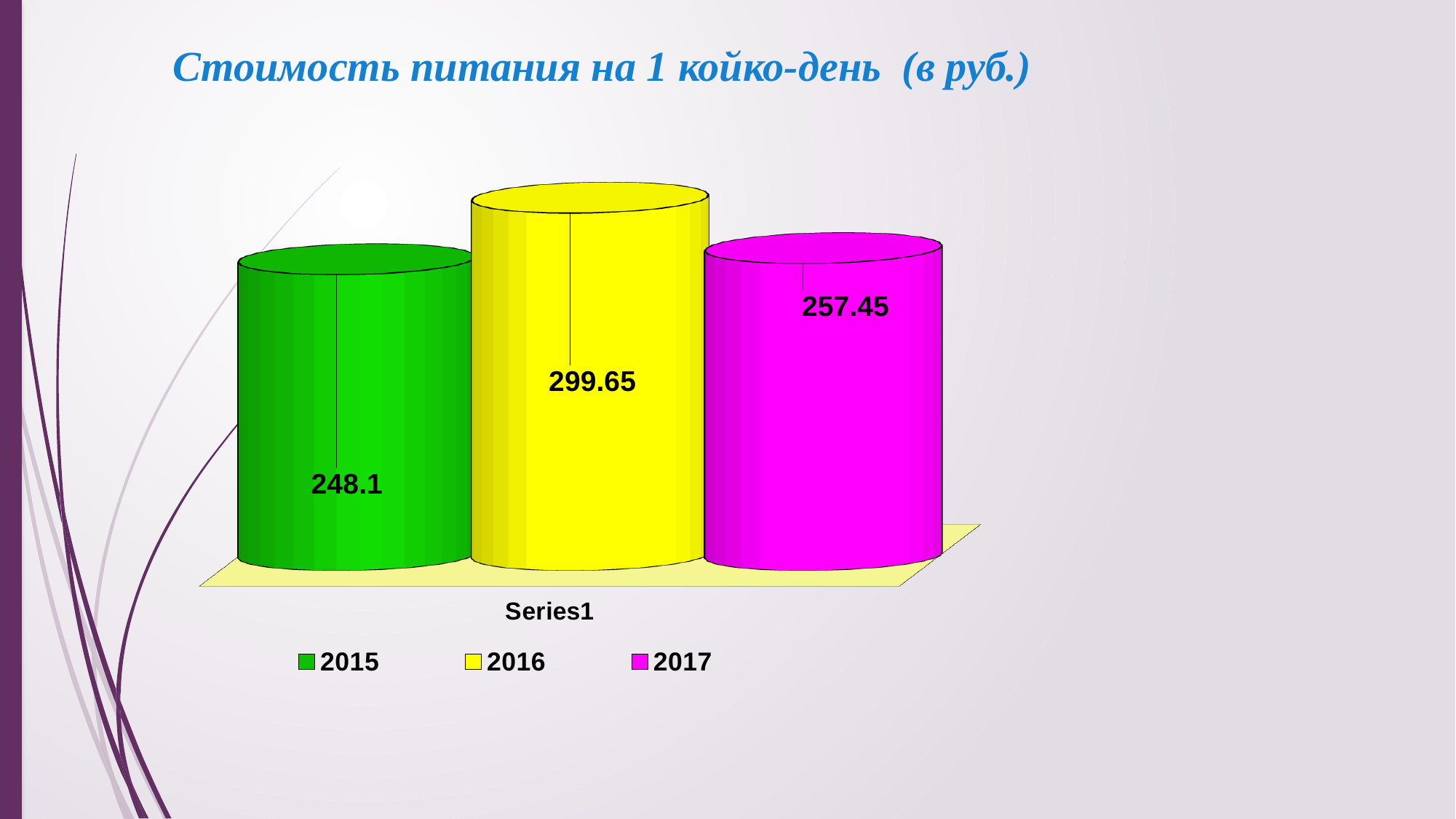
How many series does the legend list? 3 Which year has the lowest value? 2015 What is the difference between the values for 2017 and 2015? 9.35 What is the difference between the values for 2016 and 2017? 42.2 Which is larger, the value for 2017 or the value for 2015? 2017 What is the value for 2016? 299.65 What is the difference between the values for 2016 and 2015? 51.55 What is the title of the chart? Стоимость питания на 1 койко-день (в руб.) Which year has the highest value? 2016 What is the value for 2015? 248.1 What is the value for 2017? 257.45 What kind of chart is shown on the slide? bar chart